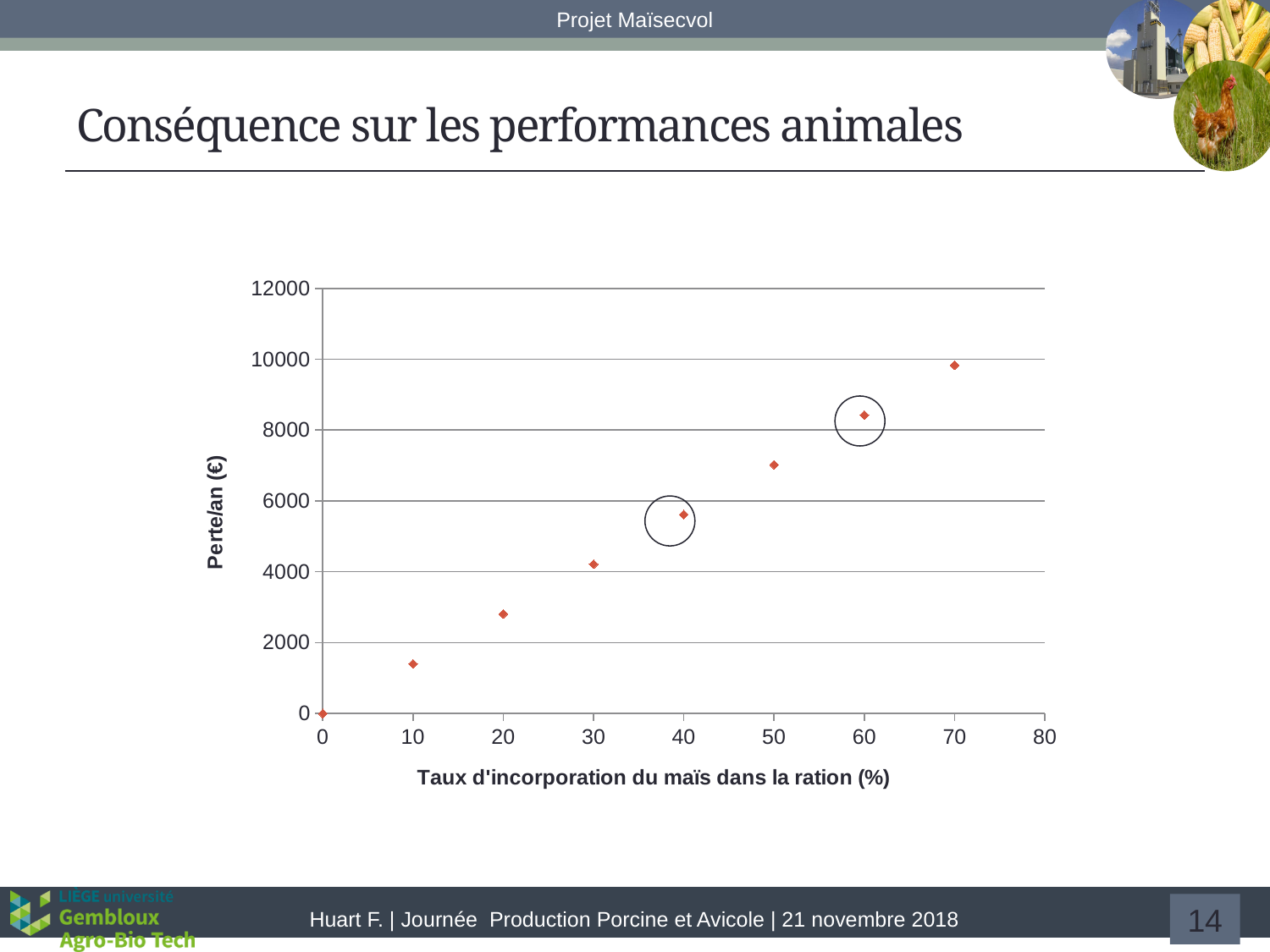
What is the title of the x axis? Taux d'incorporation du maïs dans la ration (%) What is the title of the y axis? Perte/an (€) How many data points are plotted on the chart? 8 What is the loss per year at an incorporation rate of 0%? 0 Is the loss per year at an incorporation rate of 60% greater or less than 8000? greater Is the loss per year at an incorporation rate of 10% greater or less than 2000? less At which incorporation rate is the loss per year highest? 70 At which incorporation rate is the loss per year lowest? 0 What kind of chart is shown on the slide? scatter chart Is the loss per year at an incorporation rate of 40% greater or less than 6000? less Do the values rise or fall as the incorporation rate increases along the x axis? rise